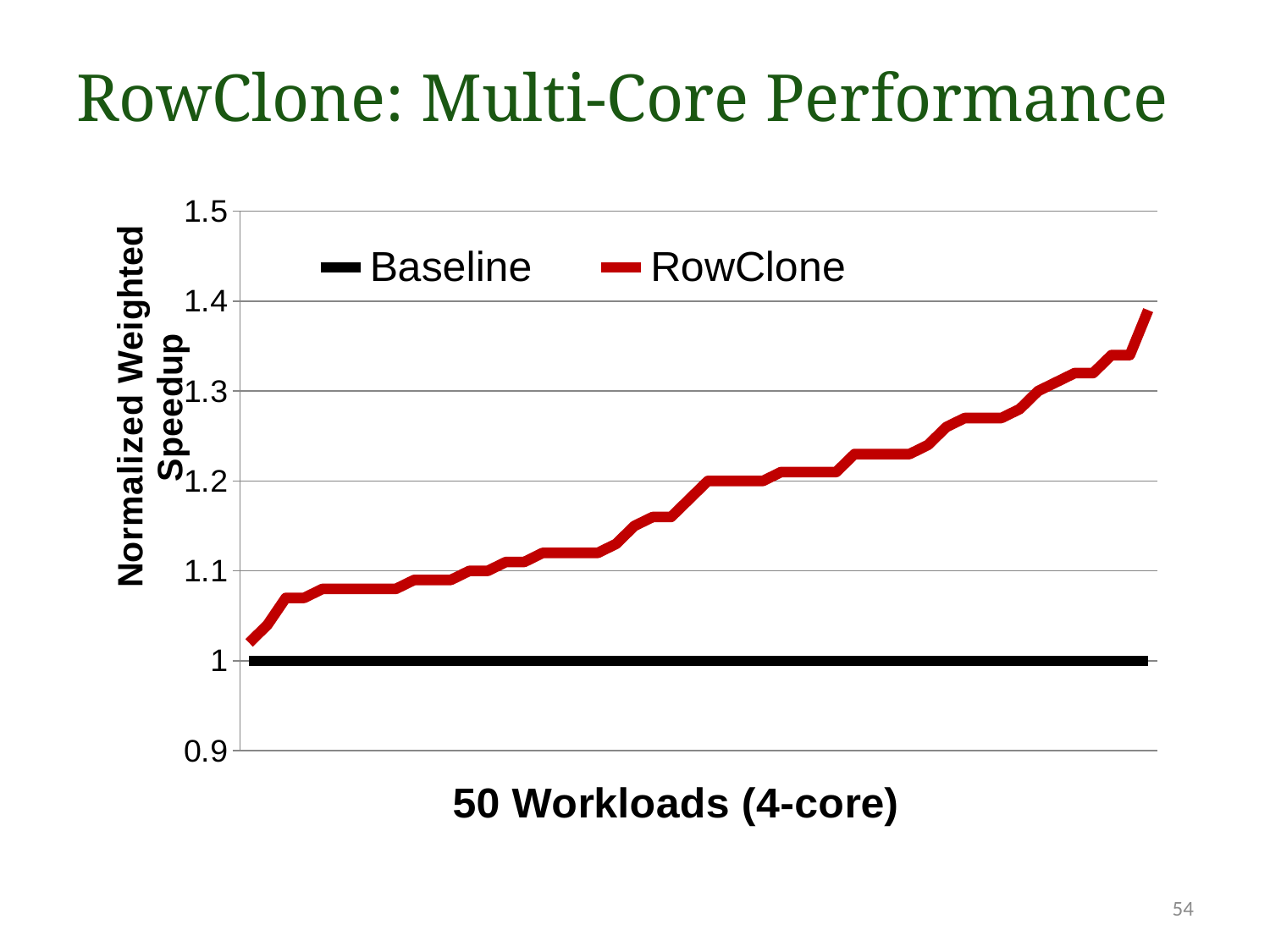
What is the title of the slide containing the chart? RowClone: Multi-Core Performance Is the highest RowClone value greater or less than 1.3? greater Is the lowest RowClone value greater or less than 1.1? less Does the RowClone series rise or fall from left to right along the x axis? rise Which two series are listed in the legend? Baseline and RowClone Is the highest RowClone value greater or less than 1.4? less What value does the Baseline series hold across all workloads? 1 What kind of chart is shown on the slide? line chart How many workloads does the x-axis label say are plotted? 50 Which series has the higher values, Baseline or RowClone? RowClone What is the label on the y axis? Normalized Weighted Speedup How many series does the legend list? 2